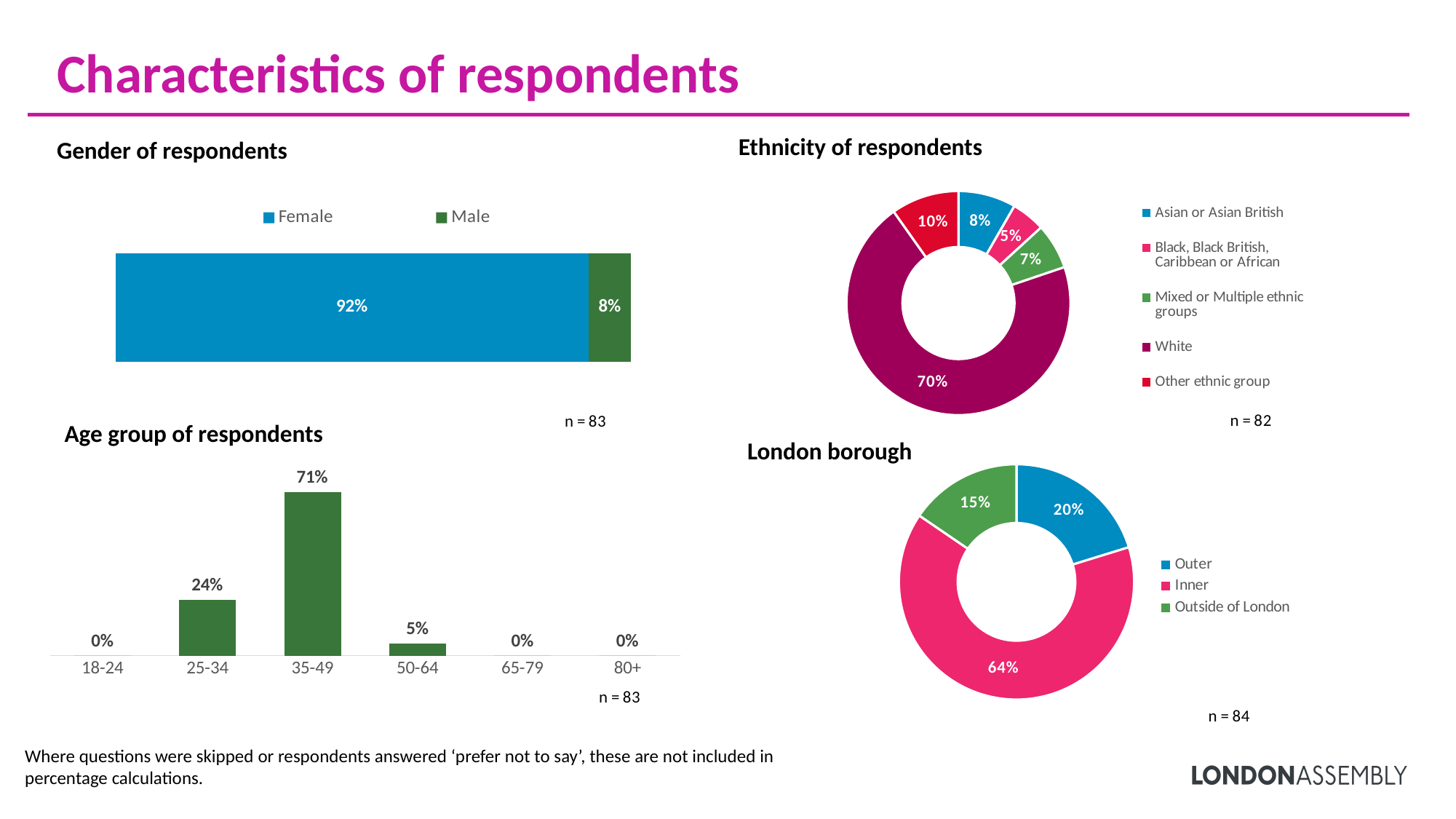
In the 'Gender of respondents' chart, what is the difference between the Female and Male percentages? 84% What kind of chart is the 'Age group of respondents' chart? Bar chart In the 'Ethnicity of respondents' chart, which ethnic group has the smallest share? Black, Black British, Caribbean or African How many categories does the legend of the 'Ethnicity of respondents' chart list? 5 In the 'London borough' chart, what share of respondents are from Inner London? 64% In the 'Age group of respondents' chart, which age group has the highest percentage? 35-49 In the 'Gender of respondents' chart, what percentage of respondents are Female? 92% In the 'Age group of respondents' chart, what is the value for the 35-49 age group? 71% In the 'Age group of respondents' chart, how many age group categories are shown on the x axis? 6 In the 'Ethnicity of respondents' chart, what share of respondents are White? 70% In the 'London borough' chart, what is the difference between the Outer and Outside of London shares? 5% In the 'Age group of respondents' chart, which is larger, the value for 25-34 or the value for 50-64? 25-34